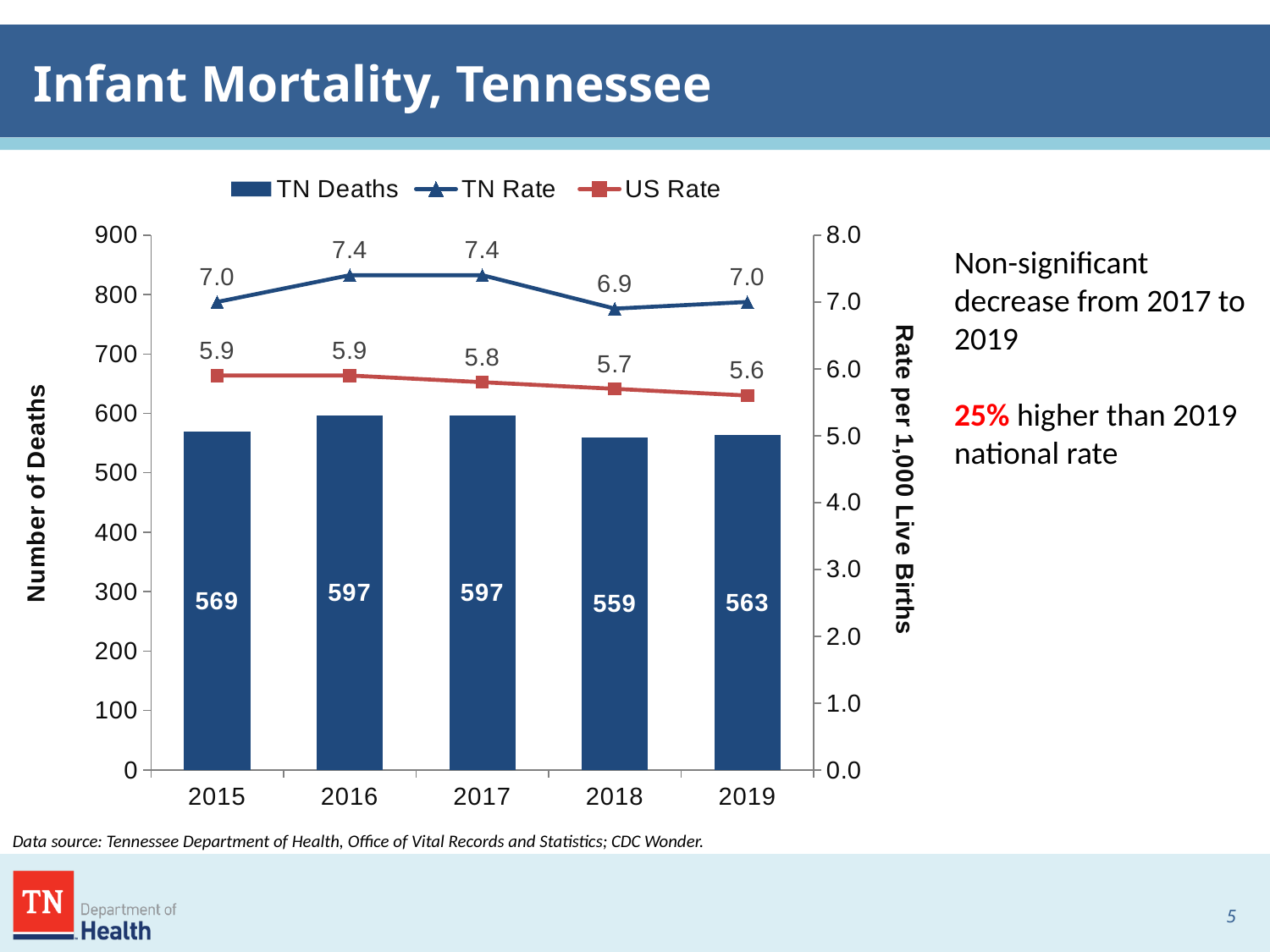
Which year had the lowest US Rate? 2019 How many series does the legend list? 3 What was the US Rate in 2019? 5.6 What was the TN Rate in 2018? 6.9 Which is larger, the TN Rate in 2016 or the TN Rate in 2019? TN Rate in 2016 What is the difference between TN Deaths in 2016 and 2018? 38 Does the US Rate rise or fall from 2015 to 2019? fall Which year had the lowest number of TN Deaths? 2018 How many years are shown on the x axis? 5 What is the label of the right-hand vertical axis? Rate per 1,000 Live Births What is the difference between the TN Rate and the US Rate in 2017? 1.6 How many TN Deaths were there in 2015? 569